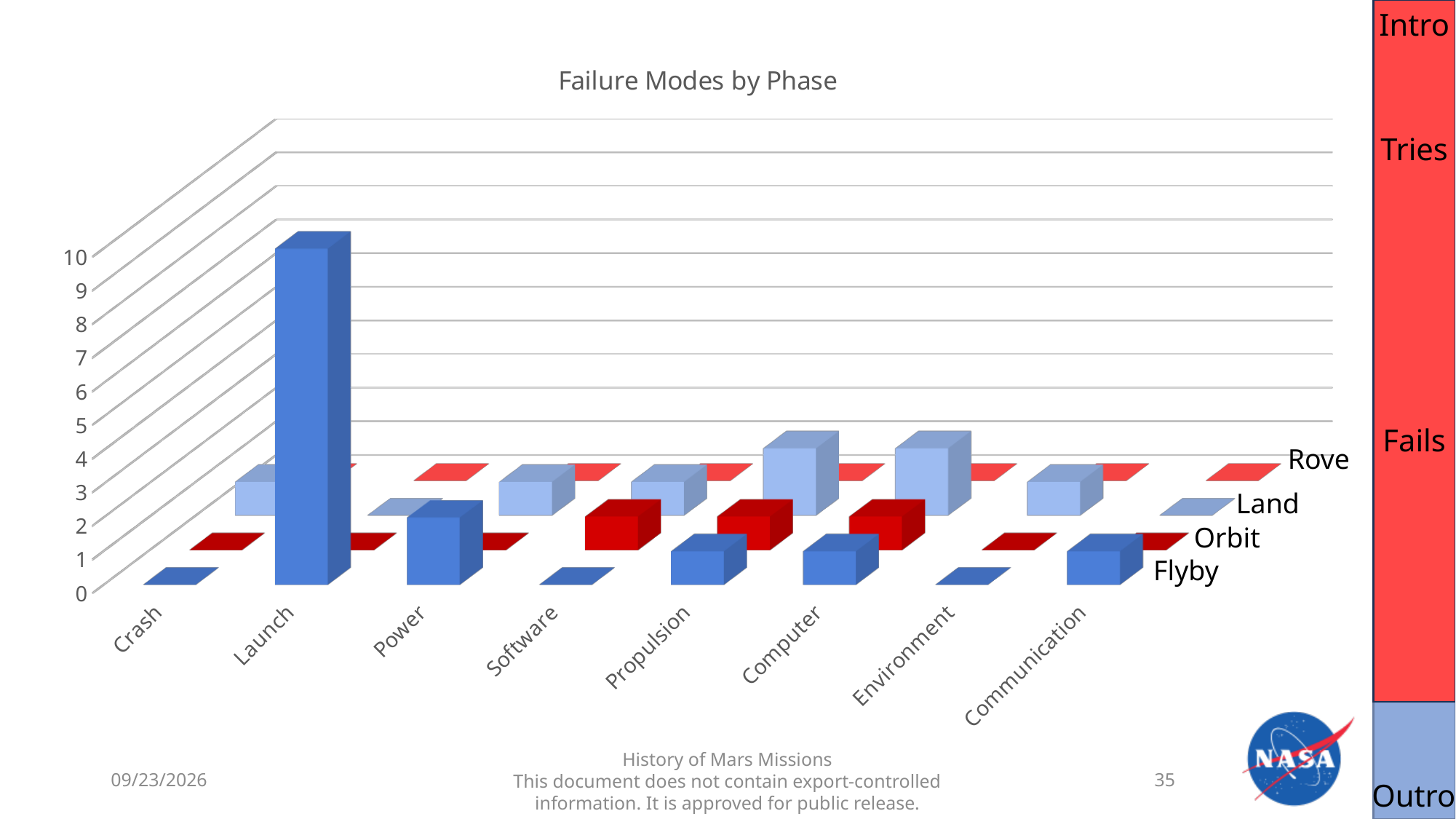
What is the title of the chart? Failure Modes by Phase Is the Flyby value for Power greater or less than 5? less What kind of chart is shown on the slide? bar chart How many categories are shown along the x axis of the chart? 8 Which category has the highest value for the Flyby series? Launch Which series are listed in the chart's legend? Flyby, Orbit, Land, Rove How many series does the chart's legend list? 4 Is the Orbit value for Propulsion greater or less than 5? less Which is larger, the Flyby value for Launch or the Flyby value for Communication? Launch Is the Flyby value for Launch greater or less than 5? greater Which is larger, the Flyby value for Launch or the Flyby value for Power? Launch Which is larger, the Flyby value for Launch or the Land value for Computer? Flyby value for Launch